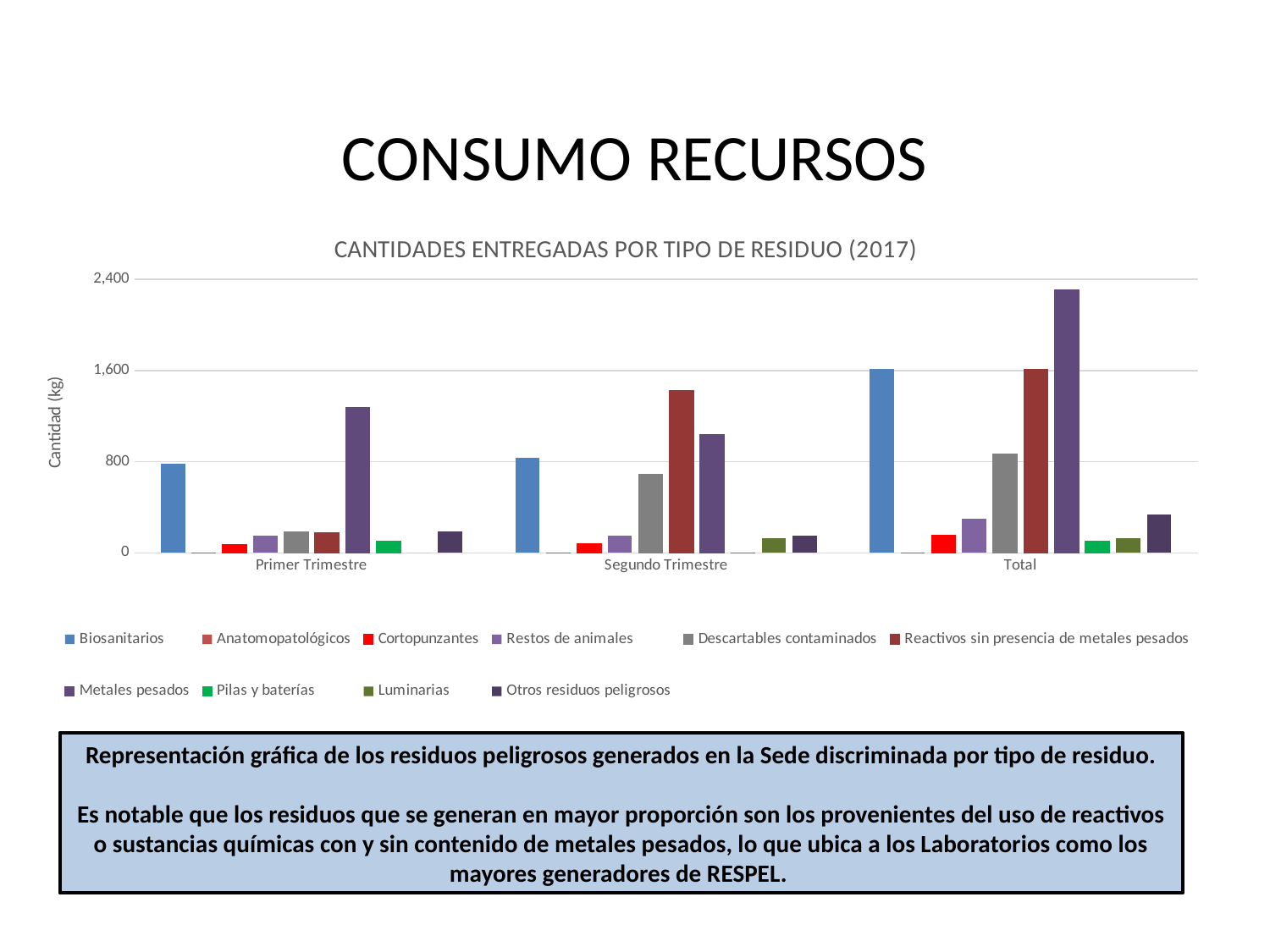
What is the title of the chart? CANTIDADES ENTREGADAS POR TIPO DE RESIDUO (2017) How many series does the chart's legend list? 10 Which series has the tallest bar in the Total category? Metales pesados What is the label of the vertical axis? Cantidad (kg) Is the value for Metales pesados in Total greater or less than 1,600? greater Which series has the tallest bar in the Primer Trimestre category? Metales pesados Which series has the tallest bar in the Segundo Trimestre category? Reactivos sin presencia de metales pesados In Primer Trimestre, which is larger: Biosanitarios or Metales pesados? Metales pesados What kind of chart is shown on the slide? Bar chart How many categories are shown on the x axis of the chart? 3 Is the value for Descartables contaminados in Segundo Trimestre greater or less than 800? less Is the value for Reactivos sin presencia de metales pesados in Segundo Trimestre greater or less than 800? greater